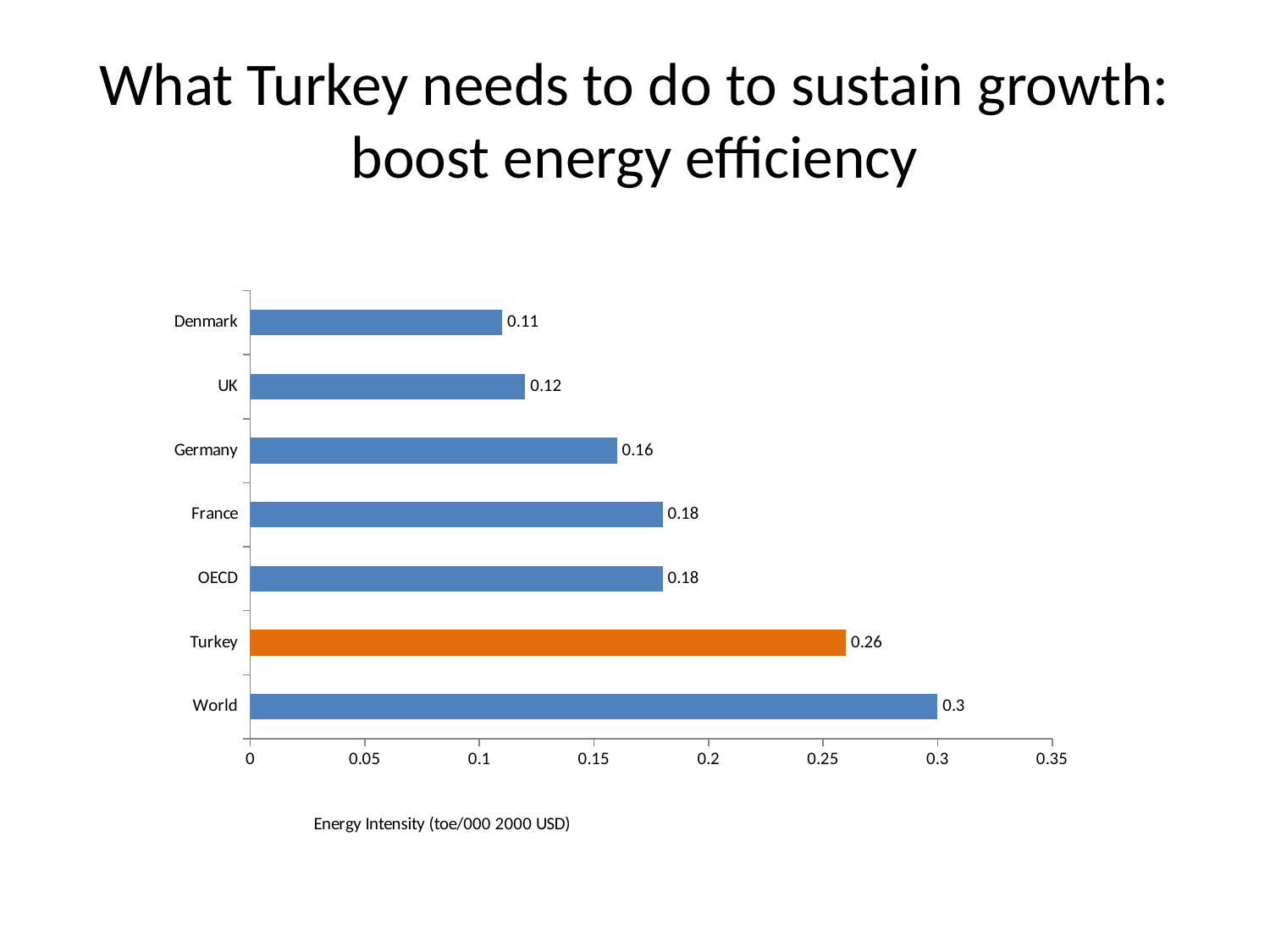
Is the value for Turkey greater or less than 0.25? greater What is the difference between the energy intensity of Turkey and the OECD? 0.08 What is the energy intensity value for Denmark? 0.11 What kind of chart is shown on the slide? Bar chart How many categories are shown in the chart? 7 What is the difference between the energy intensity of the World and Turkey? 0.04 Which bar is coloured orange rather than blue? Turkey What is the energy intensity value for Turkey? 0.26 Which category has the highest energy intensity? World What is the energy intensity value for Germany? 0.16 Which has a higher energy intensity, Turkey or France? Turkey Which category has the lowest energy intensity? Denmark